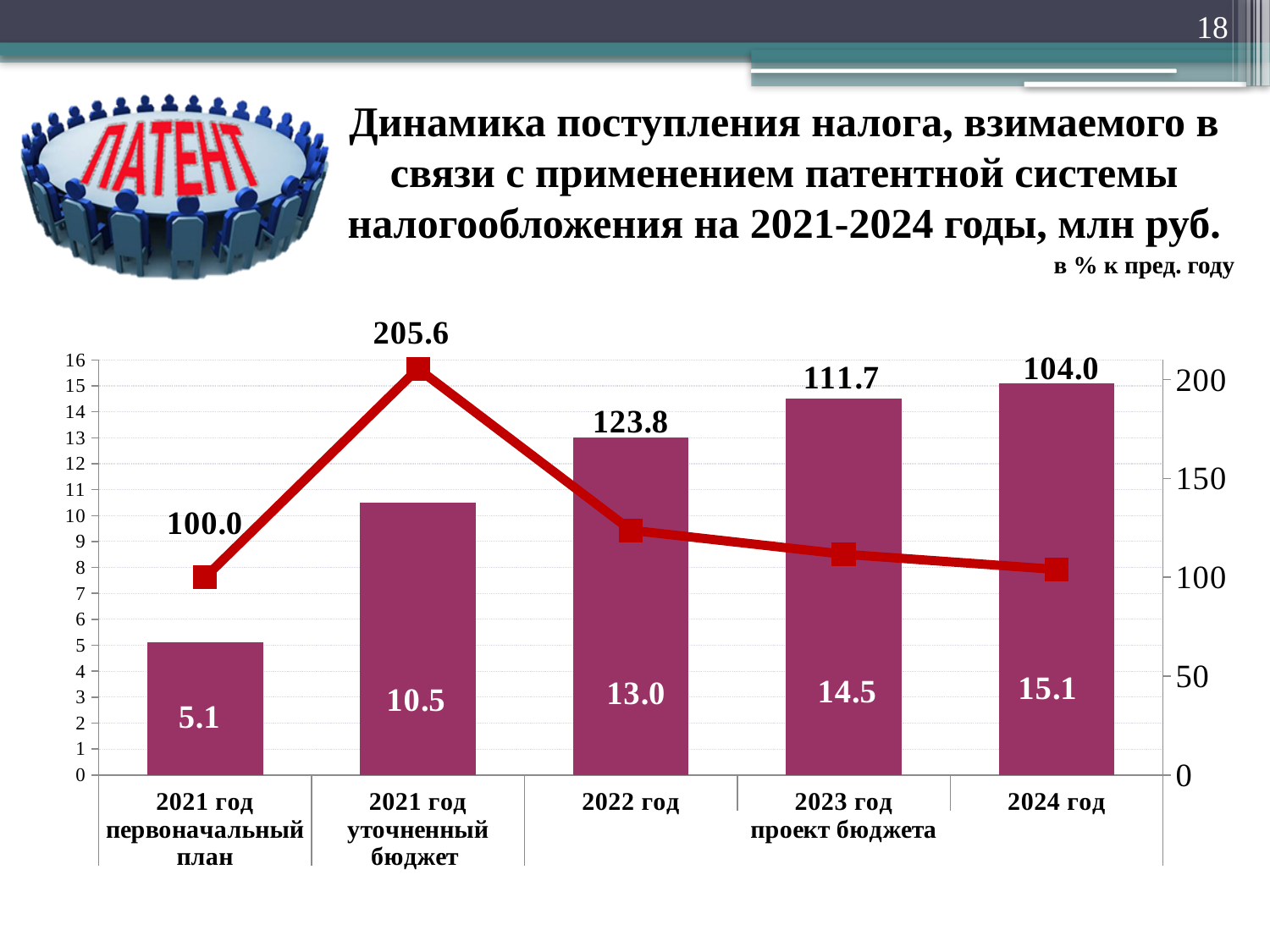
What is the bar value (млн руб.) for 2021 год уточненный бюджет? 10.5 What is the line value (в % к пред. году) for 2021 год уточненный бюджет? 205.6 Which category has the highest bar value? 2024 год What kind of chart is shown on the slide? combined bar and line chart What is the bar value (млн руб.) for 2024 год? 15.1 How many categories are shown on the x axis? 5 Which category has the lowest bar value? 2021 год первоначальный план What is the difference between the bar values for 2021 год уточненный бюджет and 2021 год первоначальный план? 5.4 Which is larger: the bar value for 2023 год or for 2022 год? 2023 год Do the bar values rise or fall from left to right along the x axis? rise Which category has the highest line value (в % к пред. году)? 2021 год уточненный бюджет What is the line value (в % к пред. году) for 2022 год? 123.8